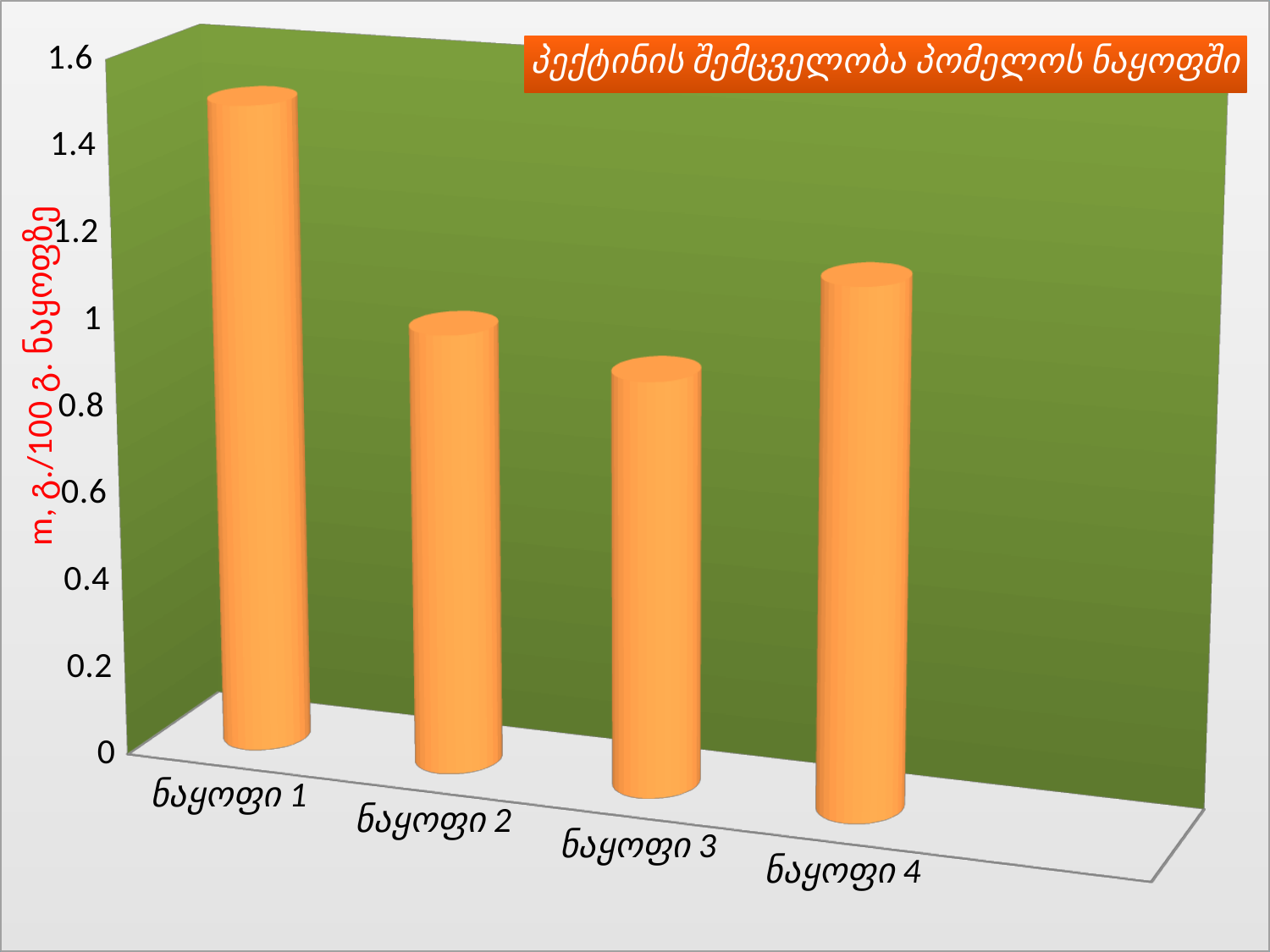
Which is larger, the value for ნაყოფი 1 or the value for ნაყოფი 3? ნაყოფი 1 Is the value for ნაყოფი 2 greater or less than 1.4? less Which category has the highest pectin content? ნაყოფი 1 How many categories (fruits) are plotted on the chart? 4 Is the value for ნაყოფი 4 greater or less than 0.8? greater Which is larger, the value for ნაყოფი 4 or the value for ნაყოფი 2? ნაყოფი 4 What is the title of the chart? პექტინის შემცველობა პომელოს ნაყოფში What is the label of the vertical axis? m, გ./100 გ. ნაყოფზე Is the value for ნაყოფი 3 greater or less than 1.2? less What kind of chart is shown on the slide? bar chart